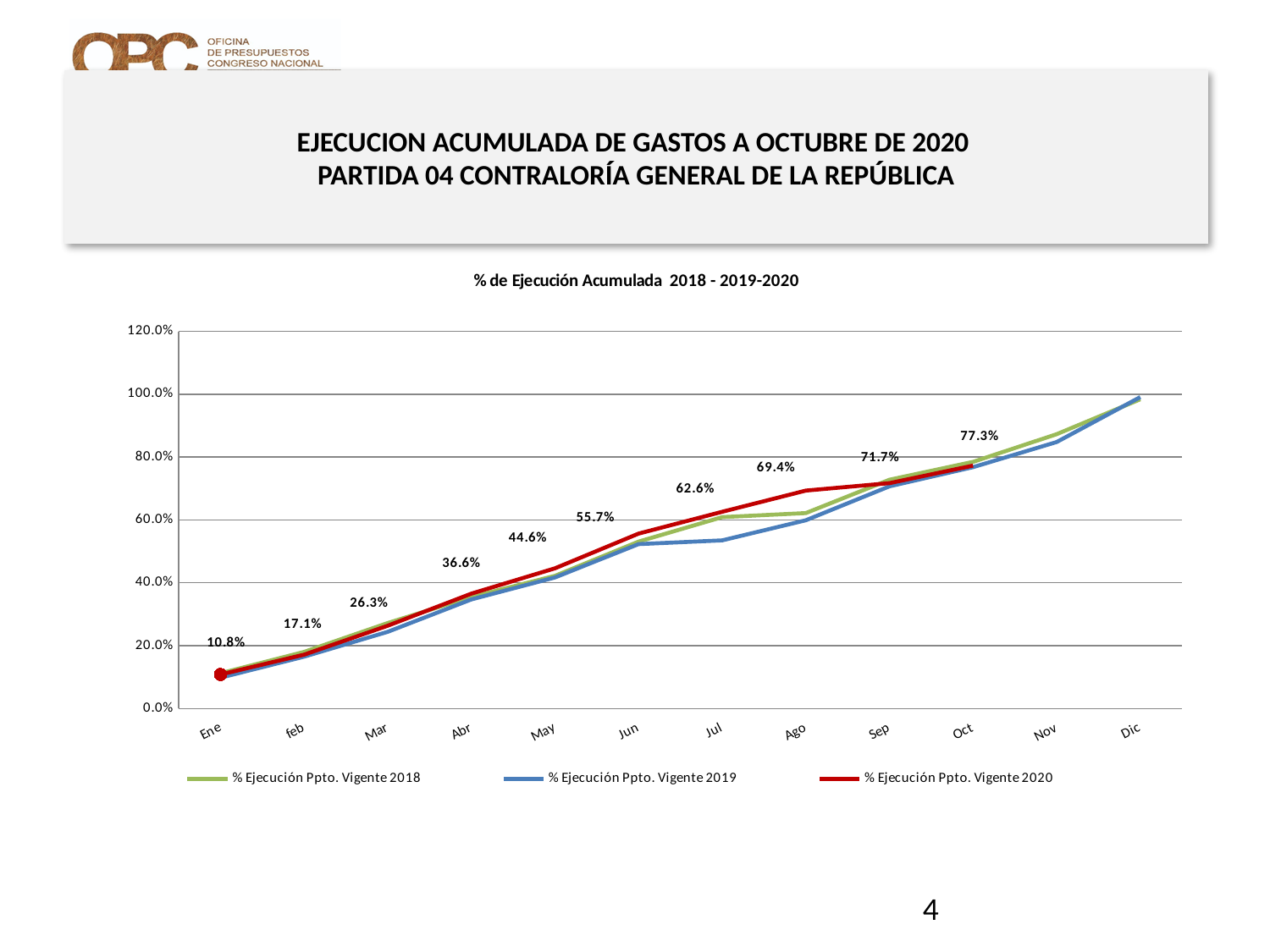
What is the value of % Ejecución Ppto. Vigente 2020 for Jun? 55.7% What is the difference between the % Ejecución Ppto. Vigente 2020 values for Oct and Sep? 5.6% How many series does the legend list? 3 What kind of chart is shown on the slide? line chart What is the value of % Ejecución Ppto. Vigente 2020 for Ene? 10.8% What is the value of % Ejecución Ppto. Vigente 2020 for Ago? 69.4% What is the value of % Ejecución Ppto. Vigente 2020 for Oct? 77.3% What is the difference between the % Ejecución Ppto. Vigente 2020 values for Mar and Feb? 9.2% Which month has the highest labelled value for % Ejecución Ppto. Vigente 2020? Oct Is the value of % Ejecución Ppto. Vigente 2019 for Jul greater or less than 60.0%? less How many months are shown on the x axis? 12 Which month has the lowest labelled value for % Ejecución Ppto. Vigente 2020? Ene